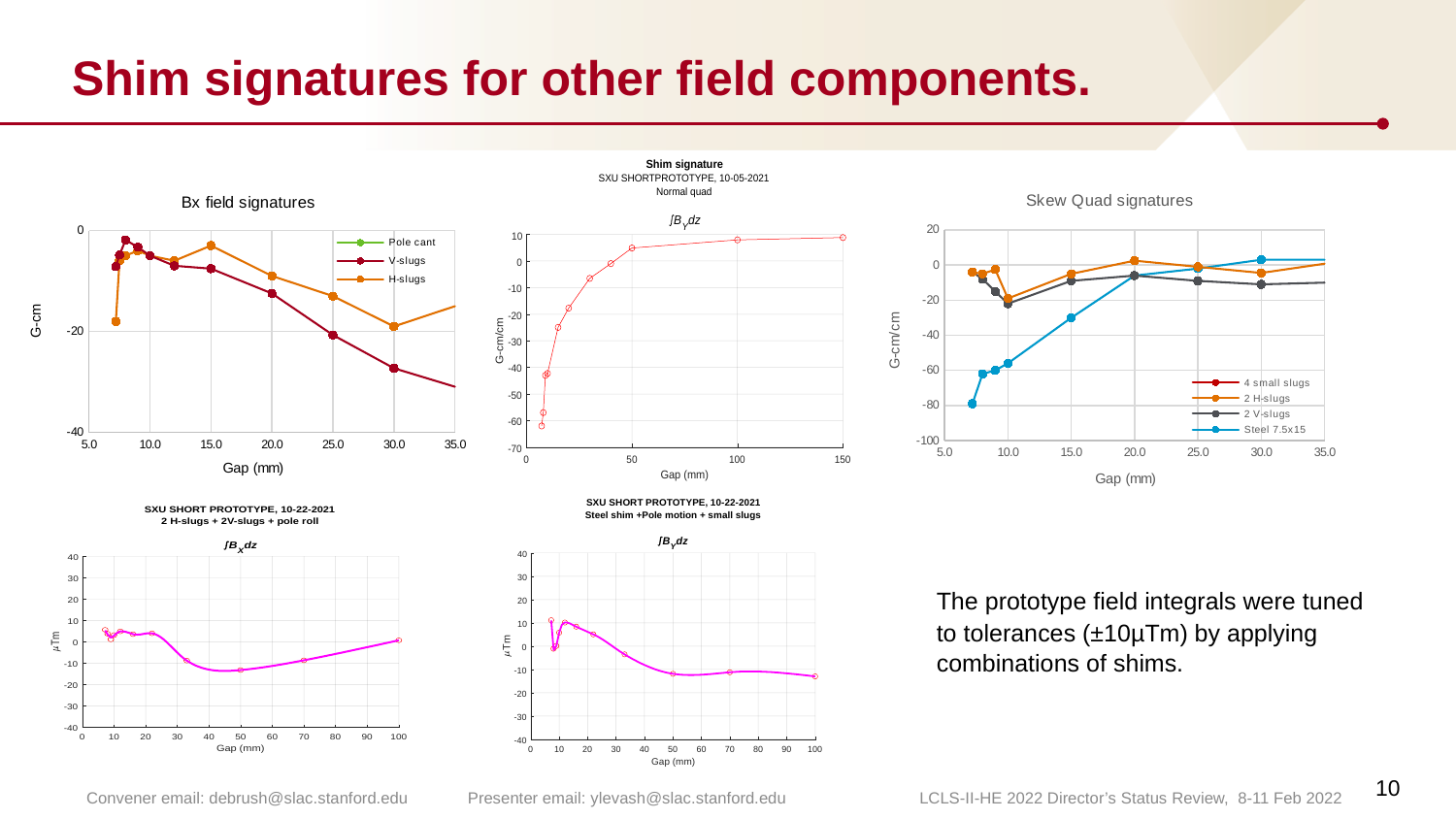
In the 'Bx field signatures' chart, is the V-slugs value at a gap of 30.0 mm greater or less than -20? less What kind of chart is the 'Bx field signatures' chart? line chart In the 'Shim signature' Normal quad chart, does the value rise or fall as the gap increases? rise In the 'Skew Quad signatures' chart, which series has the lowest value at a gap of about 7 mm? Steel 7.5x15 In the 'Skew Quad signatures' chart, is the Steel 7.5x15 value at a gap of 15.0 mm greater or less than -20? less How many series does the legend of the 'Bx field signatures' chart list? 3 How many series does the legend of the 'Skew Quad signatures' chart list? 4 In the bottom-left chart ('2 H-slugs + 2V-slugs + pole roll'), is the value at a gap of 50 mm greater or less than 0? less In the 'Bx field signatures' chart, do the V-slugs values rise or fall as the gap increases from 10 mm to 35 mm? fall What unit is shown on the y axis of the bottom-middle chart ('Steel shim + Pole motion + small slugs')? µTm In the 'Bx field signatures' chart, at a gap of 30.0 mm, which series has the higher value, H-slugs or V-slugs? H-slugs